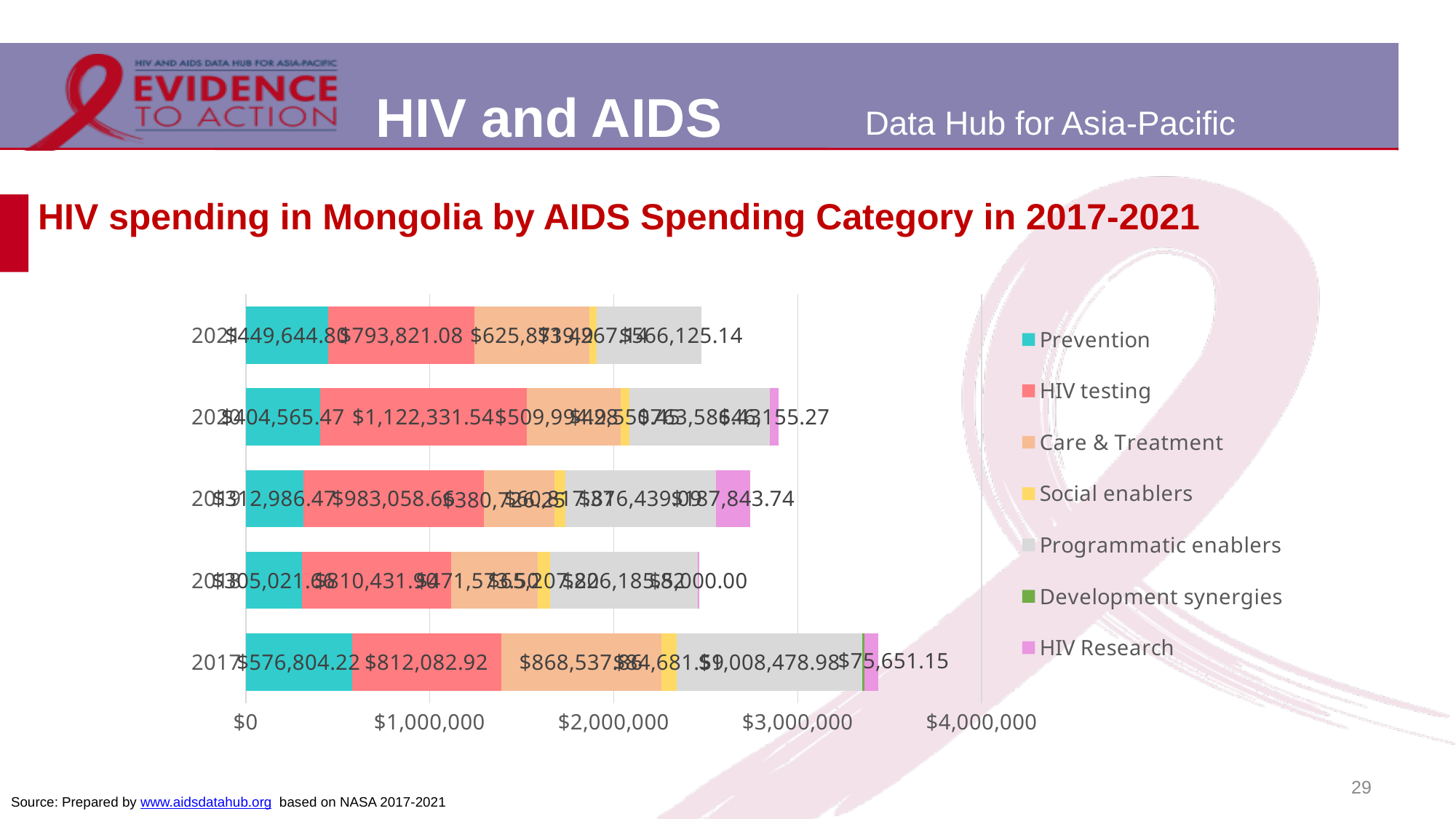
Is the total HIV spending in 2021 greater or less than $3,000,000? less Was HIV testing spending larger in 2020 or in 2017? 2020 Which year had the highest total HIV spending? 2017 What was HIV spending on HIV testing in Mongolia in 2020? $1,122,331.54 What was HIV spending on Prevention in Mongolia in 2017? $576,804.22 What is the difference between Prevention spending in 2017 ($576,804.22) and in 2020 ($404,565.47)? $172,238.75 What was HIV spending on HIV Research in Mongolia in 2017? $75,651.15 How many series does the legend list? 7 How many years are plotted on the chart? 5 What was HIV spending on Programmatic enablers in Mongolia in 2017? $1,008,478.98 Which year had the highest spending on HIV testing? 2020 What kind of chart is shown on the slide? Stacked bar chart